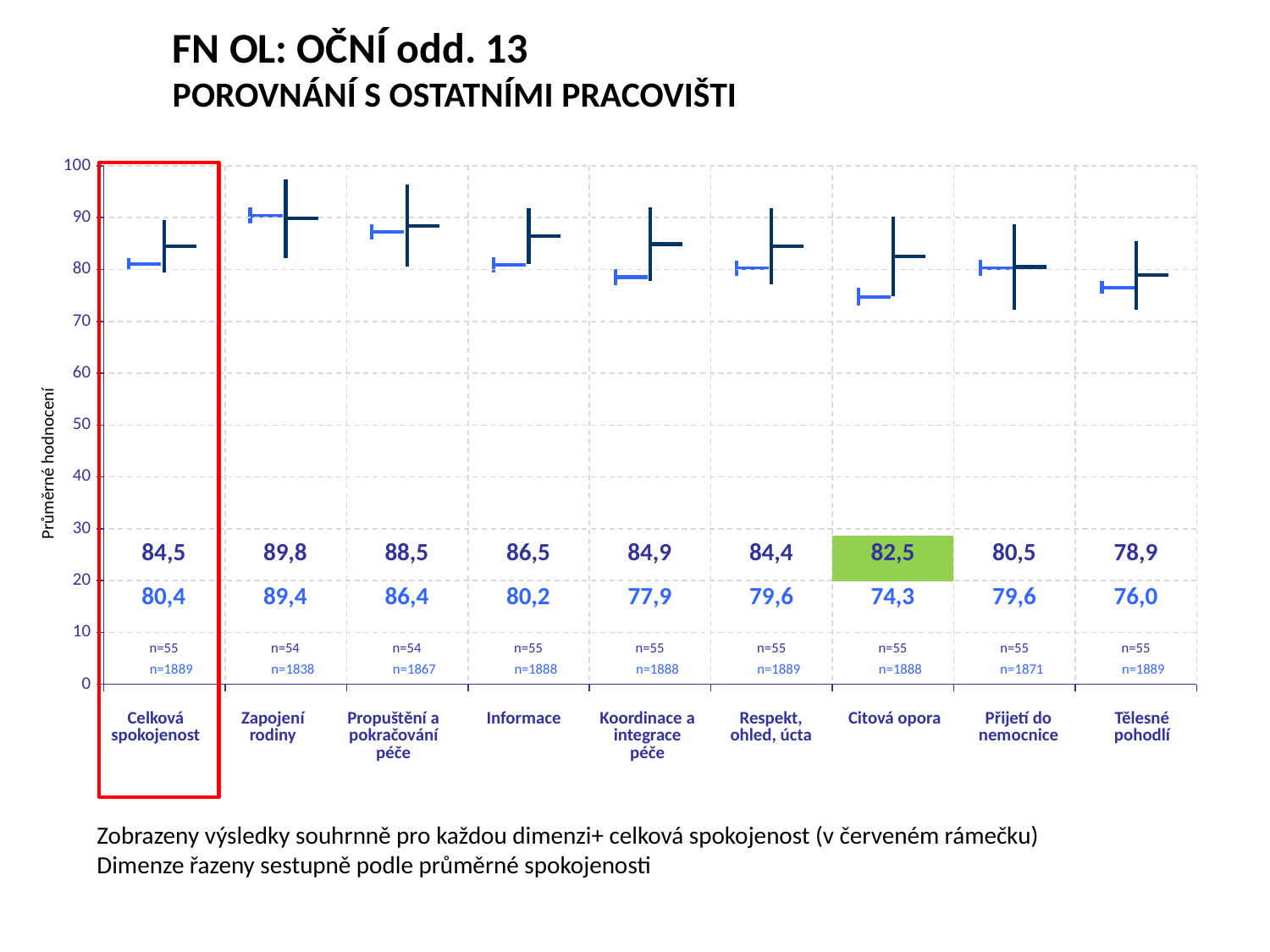
What is the n value printed in dark blue for Zapojení rodiny? n=54 What is the dark blue value shown for Zapojení rodiny? 89,8 Which category has the highest dark blue value? Zapojení rodiny What is the light blue value shown for Citová opora? 74,3 Which category has the lowest light blue value? Citová opora What is the difference between the dark blue and light blue values for Citová opora? 8,2 How many categories are shown along the x axis? 9 Which category is highlighted with a green box? Citová opora What is the dark blue value shown for Celková spokojenost? 84,5 Which is larger for Informace: the dark blue value or the light blue value? the dark blue value Which category has the lowest dark blue value? Tělesné pohodlí What is the difference between the dark blue values for Zapojení rodiny and Tělesné pohodlí? 10,9